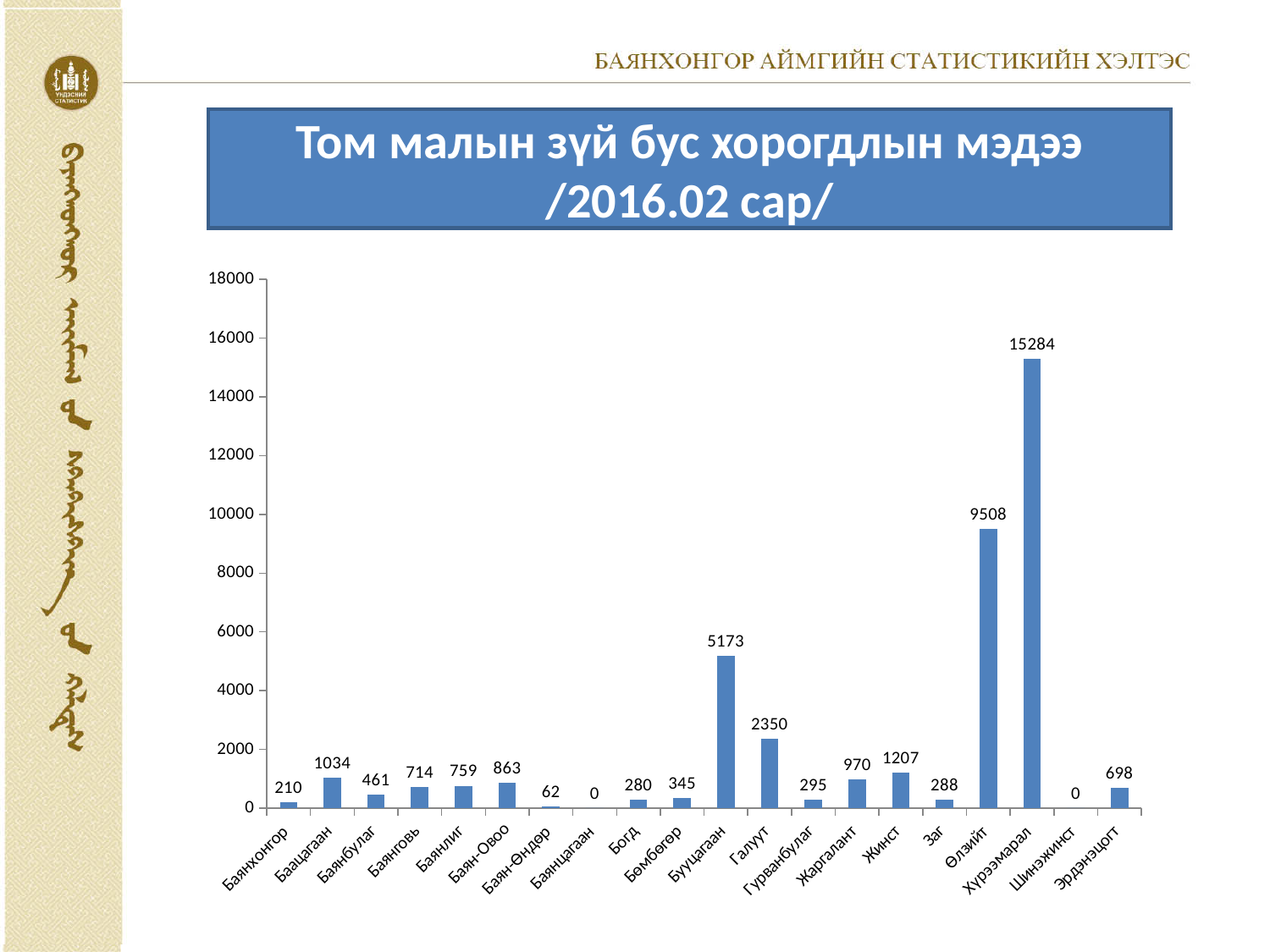
What is the title of the chart? Том малын зүй бус хорогдлын мэдээ /2016.02 сар/ Is the value for Өлзийт greater or less than 10000? less Which category has the highest value? Хүрээмарал What is the value for Бууцагаан? 5173 What is the difference between the values for Бууцагаан and Галуут? 2823 What kind of chart is shown on the slide? bar chart What is the value for Баян-Өндөр? 62 Which is larger, the value for Баацагаан or the value for Жинст? Жинст How many categories are shown on the x axis? 20 What is the difference between the values for Хүрээмарал and Өлзийт? 5776 What is the value for Жинст? 1207 What is the value for Хүрээмарал? 15284